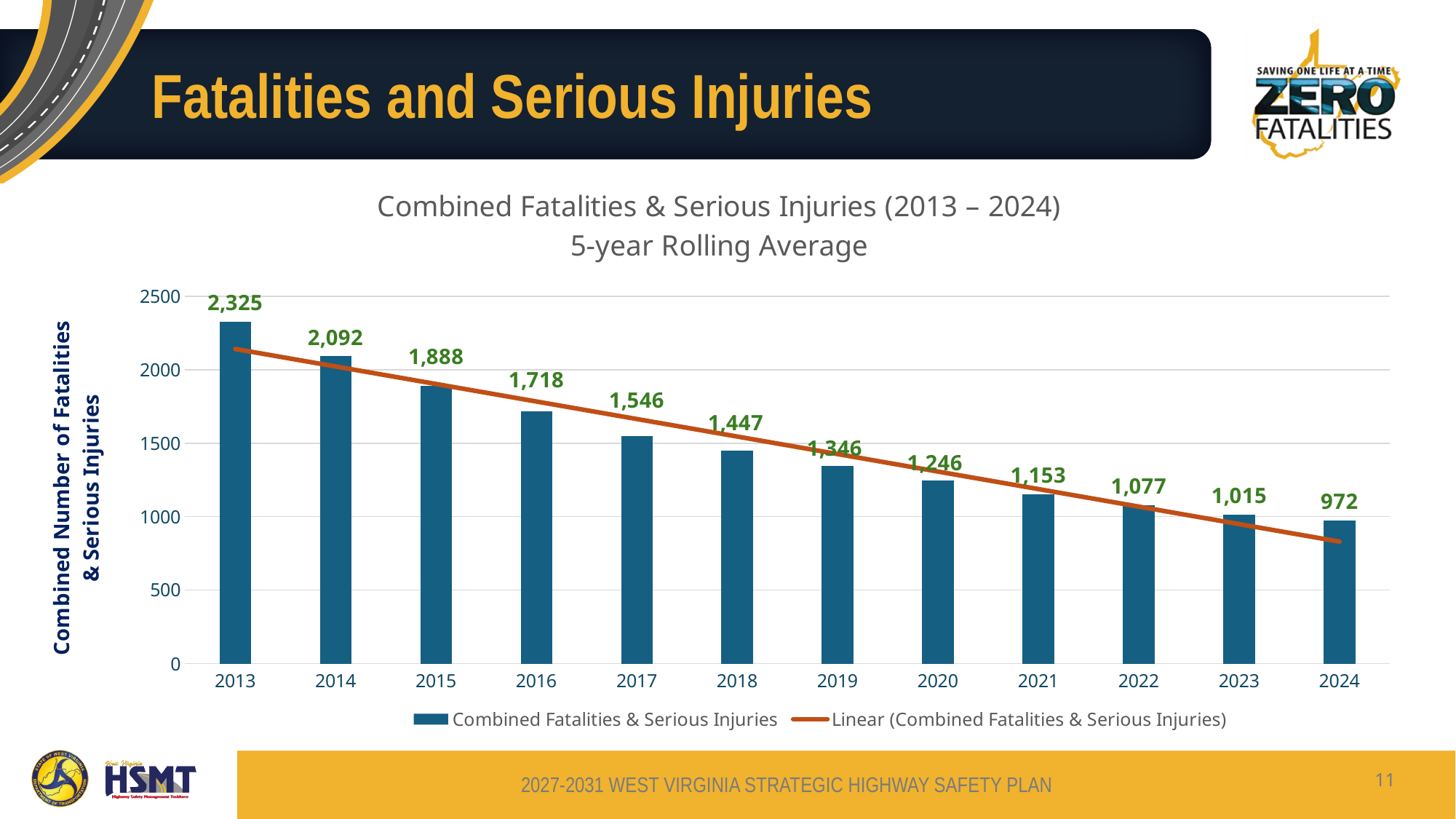
Which year has the highest value? 2013 Is the value for 2021 greater or less than 1000? greater Which year has the lowest value? 2024 What is the value for 2024? 972 What is the value for 2013? 2,325 Which is larger, the value for 2015 or the value for 2018? 2015 What kind of chart is this? bar chart Do the values rise or fall from 2013 to 2024? fall What is the difference between the values for 2016 and 2017? 172 What is the difference between the values for 2013 and 2024? 1,353 How many years are shown on the x axis? 12 What is the value for 2019? 1,346